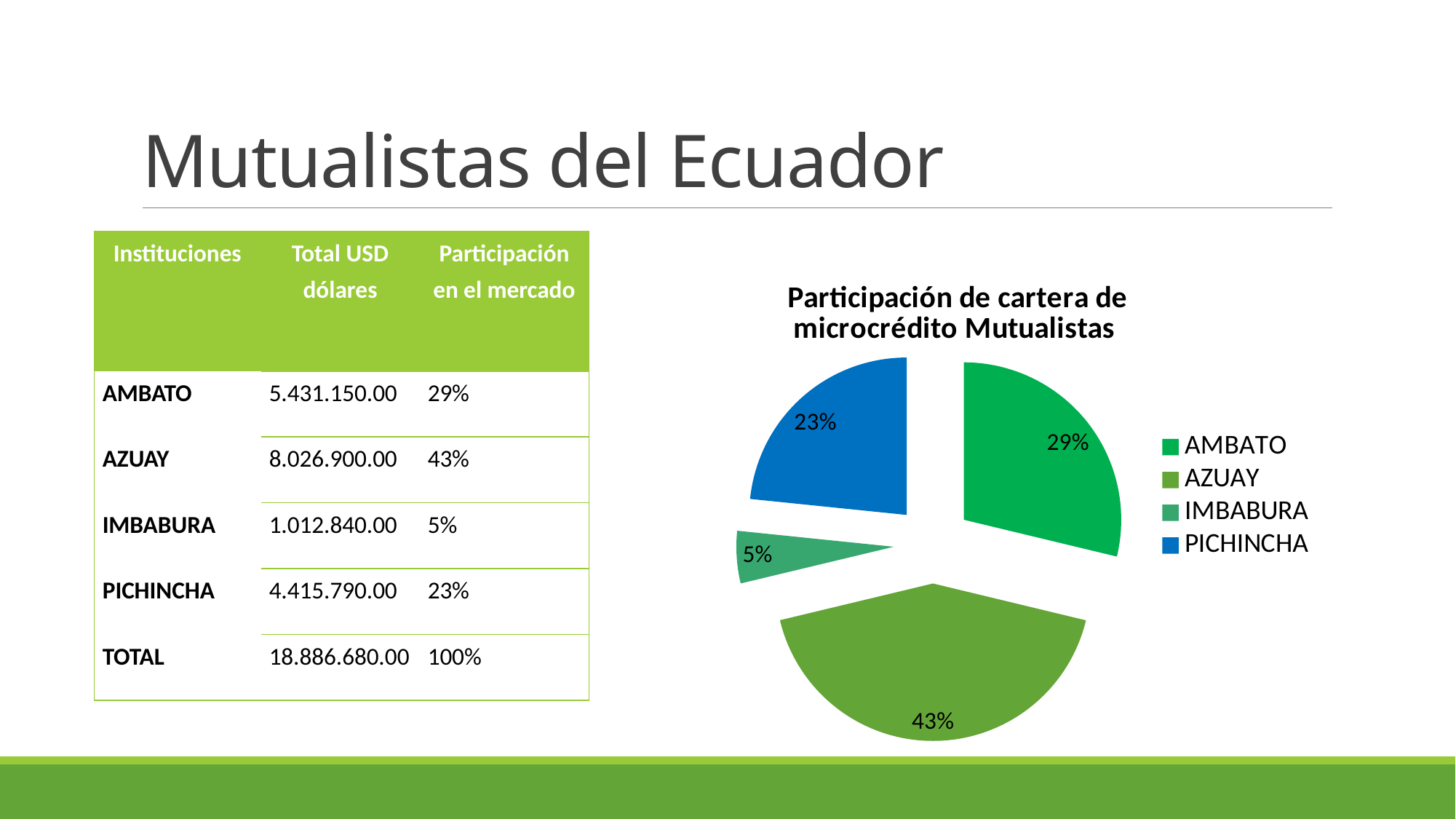
What share of the pie does AMBATO hold? 29% What share of the pie does IMBABURA hold? 5% Which slice is larger, AMBATO or PICHINCHA? AMBATO What share of the pie does AZUAY hold? 43% Which institution has the largest slice of the pie? AZUAY What is the title of the chart? Participación de cartera de microcrédito Mutualistas What is the difference in percentage points between the AZUAY slice and the AMBATO slice? 14 How many entries does the legend list? 4 What type of chart is shown on the slide? pie chart How many slices does the pie chart have? 4 Which institution has the smallest slice of the pie? IMBABURA